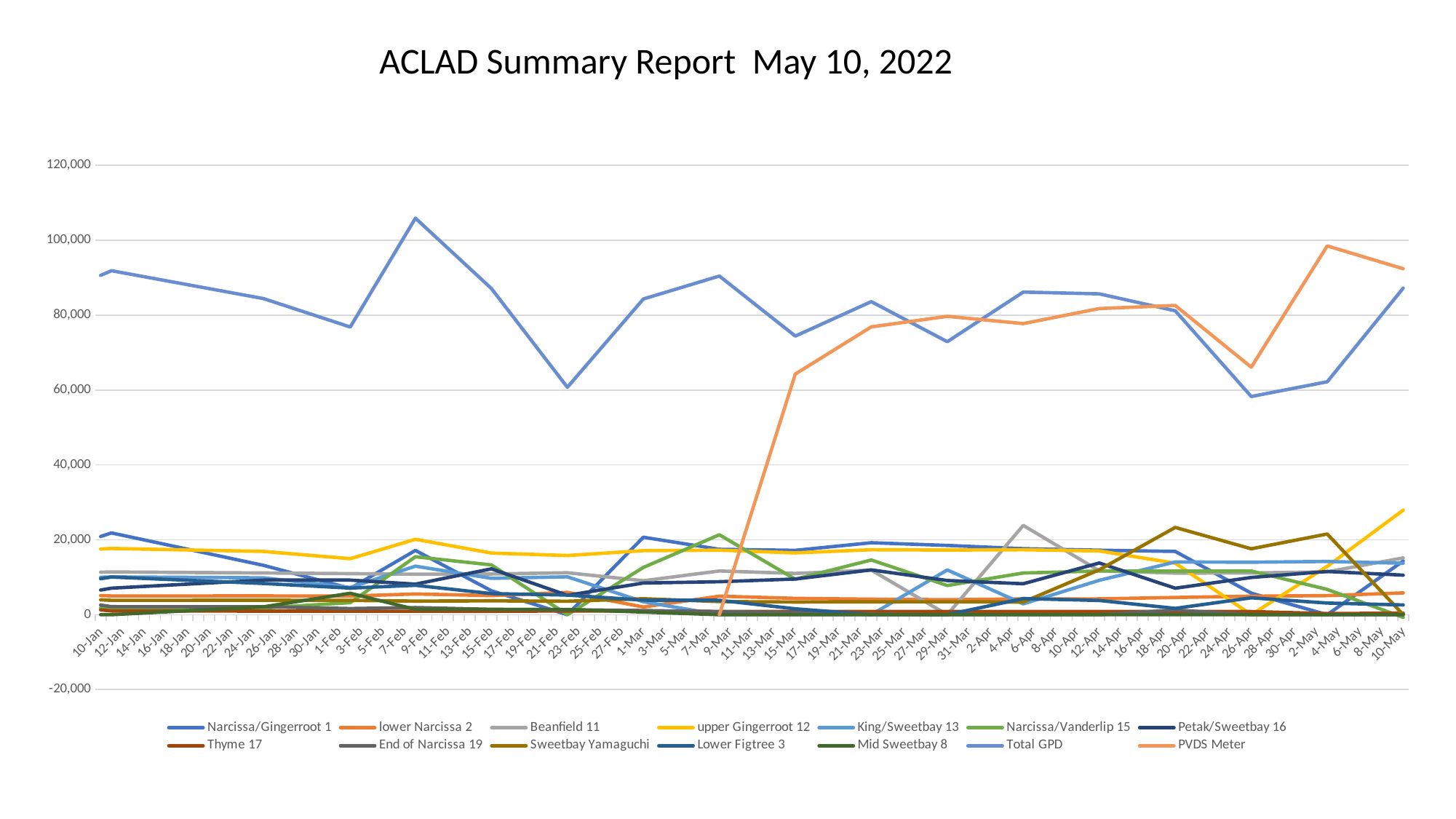
What kind of chart is shown on the slide? line chart Is the value for PVDS Meter on 4-May greater or less than 80,000? greater On 4-May, which is larger: Total GPD or PVDS Meter? PVDS Meter Is the value for Total GPD on 10-Jan greater or less than 80,000? greater How many series does the legend list? 14 Is the value for upper Gingerroot 12 on 10-May greater or less than 20,000? greater Does the PVDS Meter line rise or fall from 9-Mar to 15-Mar? rise Does the Total GPD line rise or fall from 10-Jan to 1-Feb? fall What is the title of the chart? ACLAD Summary Report May 10, 2022